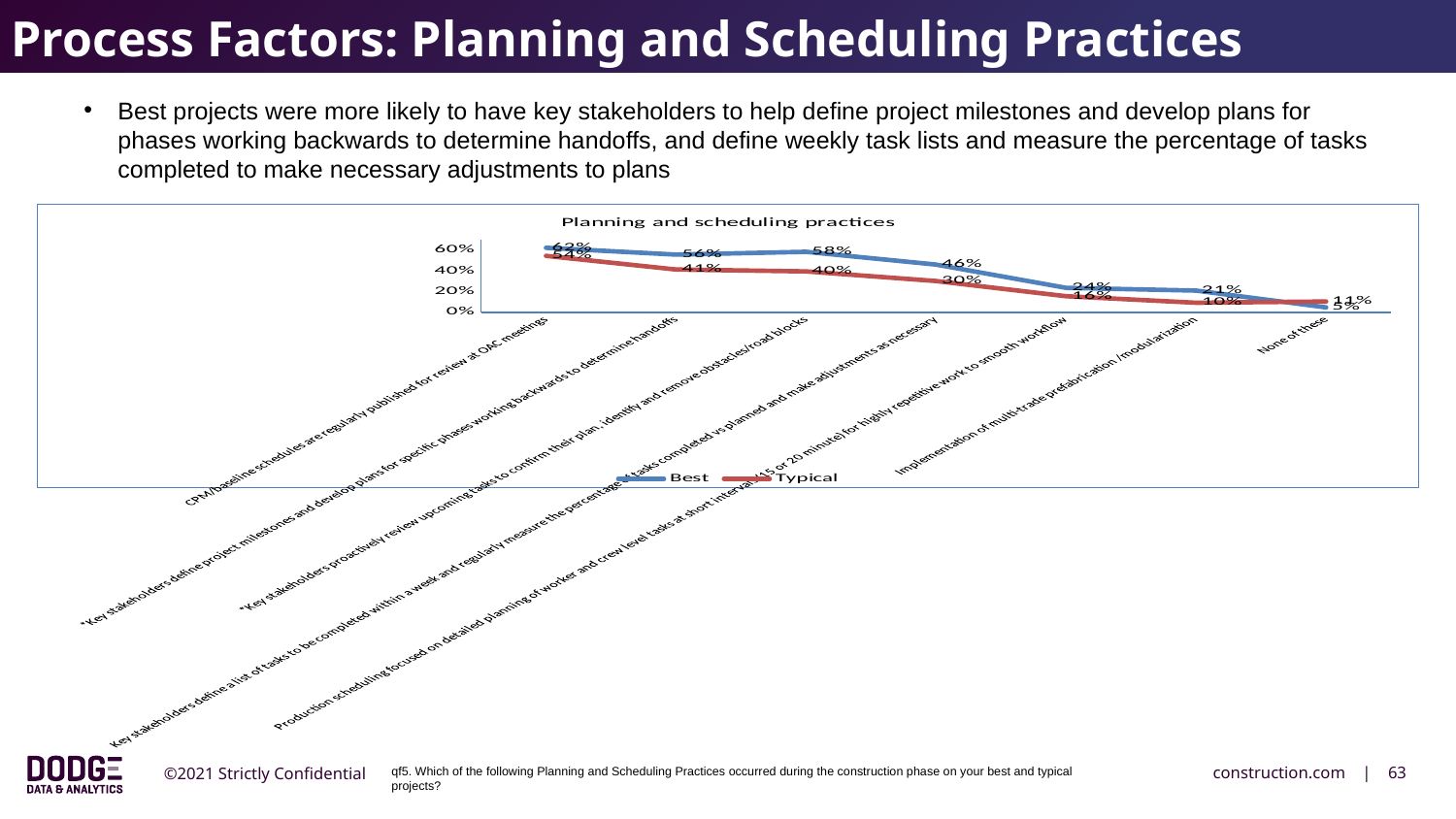
What is the Typical value for 'Key stakeholders define project milestones and develop plans for specific phases working backwards to determine handoffs'? 41% What is the difference between the Best and Typical values for 'Implementation of multi-trade prefabrication / modularization'? 11 percentage points For 'Key stakeholders proactively review upcoming tasks to confirm their plan, identify and remove obstacles/road blocks', which series has the larger value, Best or Typical? Best What is the title of the chart? Planning and scheduling practices How many practices (categories) are plotted along the x axis of the chart? 7 What is the Typical value for 'Implementation of multi-trade prefabrication / modularization'? 10% Which practice has the highest Typical value? CPM/baseline schedules are regularly published for review at OAC meetings What are the two series named in the chart legend? Best and Typical What kind of chart is shown on the slide? Line chart What is the Best value for 'Implementation of multi-trade prefabrication / modularization'? 21% Do the Best values generally rise or fall moving from left to right along the x axis? Fall How many series does the legend of the chart list? 2